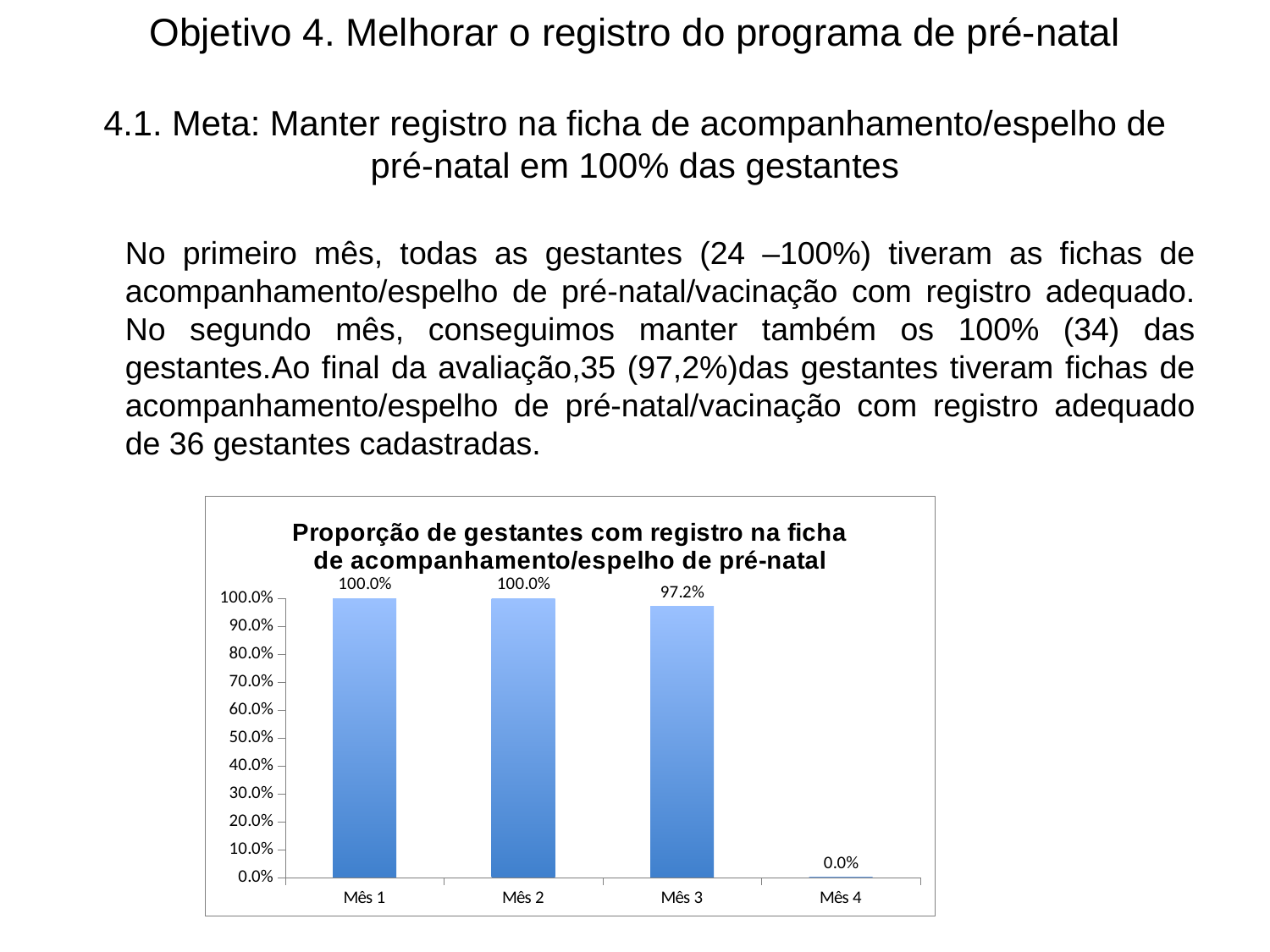
What is the value for Mês 1? 100.0% Do the values rise or fall from Mês 2 to Mês 4? fall How many categories are shown on the x axis? 4 What is the difference between the values for Mês 2 and Mês 3? 2.8% What is the title of the chart? Proporção de gestantes com registro na ficha de acompanhamento/espelho de pré-natal What is the value for Mês 4? 0.0% Which category has the lowest value? Mês 4 Which is larger, the value for Mês 1 or the value for Mês 3? Mês 1 What is the highest value shown on the y axis? 100.0% What kind of chart is shown on the slide? bar chart Is the value for Mês 3 greater or less than 90.0%? greater What is the value for Mês 3? 97.2%